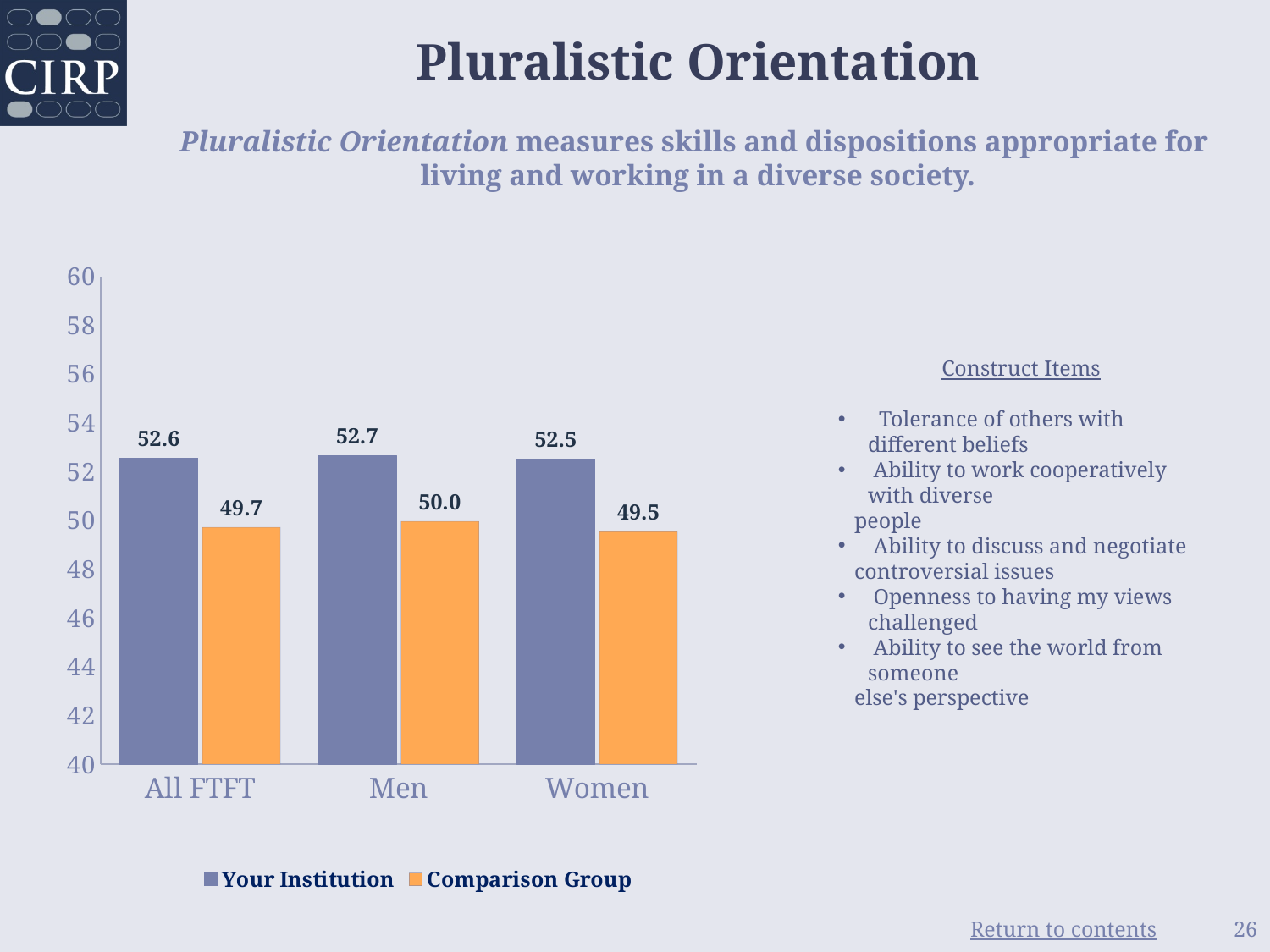
Which category has the highest Comparison Group value? Men What colour are the Comparison Group bars? Orange What is the value for Your Institution in the Men category? 52.7 What is the difference between Your Institution and Comparison Group for Women? 3.0 Which category has the lowest Comparison Group value? Women How many series does the legend list? 2 What is the difference between Your Institution and Comparison Group for All FTFT? 2.9 What is the value for Your Institution in the All FTFT category? 52.6 What is the value for Comparison Group in the Women category? 49.5 How many categories are shown on the x axis? 3 What kind of chart is shown on the slide? Bar chart Which is larger for Men: Your Institution or Comparison Group? Your Institution